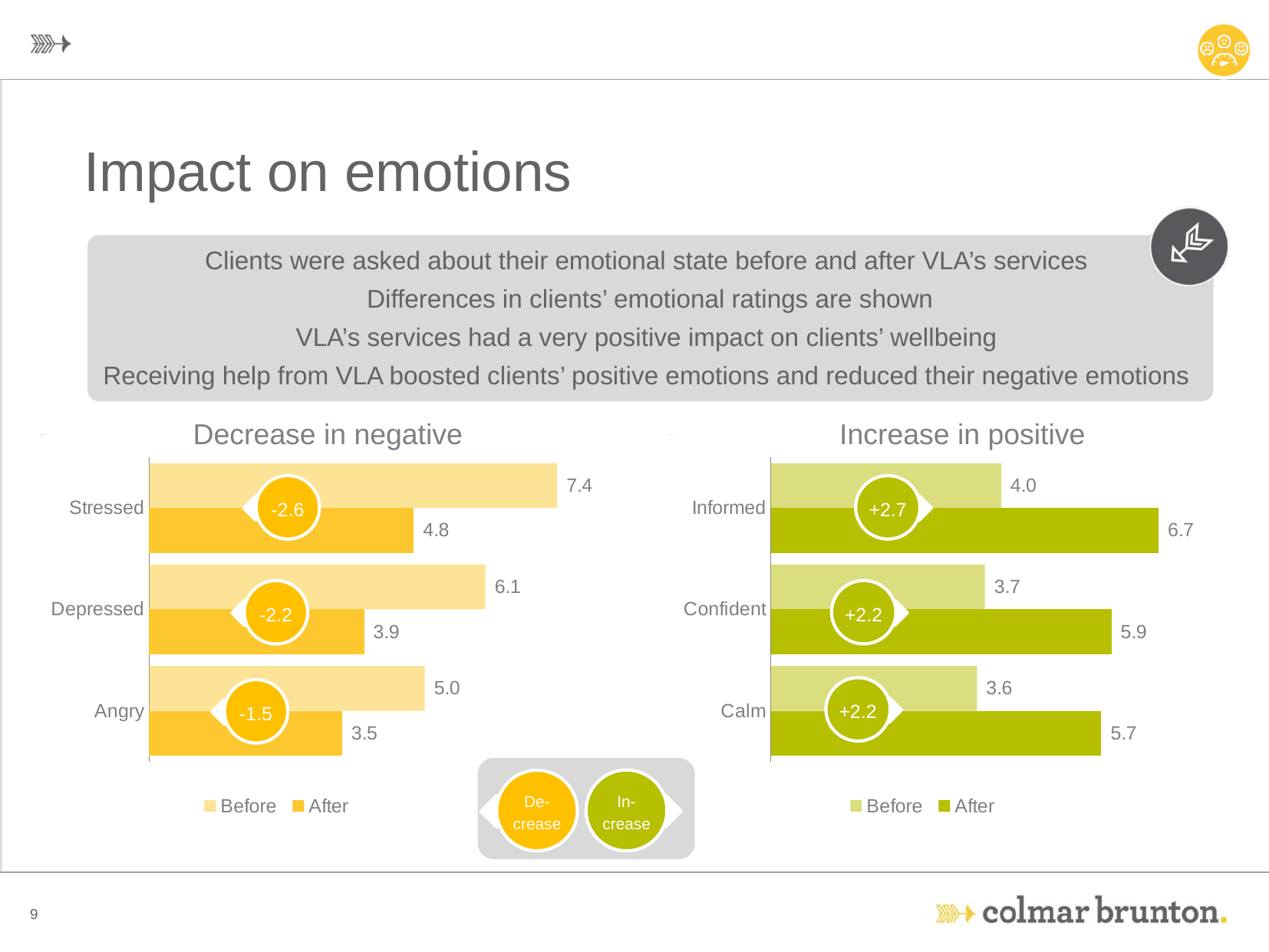
In the 'Decrease in negative' chart, what is the Before value for Stressed? 7.4 In the 'Increase in positive' chart, what is the difference between the After and Before values for Confident? 2.2 How many emotions are shown in the 'Decrease in negative' chart? 3 In the 'Decrease in negative' chart, what is the After value for Angry? 3.5 What type of chart is the 'Decrease in negative' chart? Bar chart In the 'Decrease in negative' chart, which emotion has the highest Before value? Stressed In the 'Increase in positive' chart, which emotion has the lowest After value? Calm In the 'Increase in positive' chart, is the After value for Informed larger or smaller than the After value for Confident? larger In the 'Increase in positive' chart, what is the After value for Informed? 6.7 In the 'Increase in positive' chart, what is the Before value for Calm? 3.6 How many series does the legend of the 'Increase in positive' chart list? 2 In the 'Decrease in negative' chart, what is the difference between the Before and After values for Depressed? 2.2